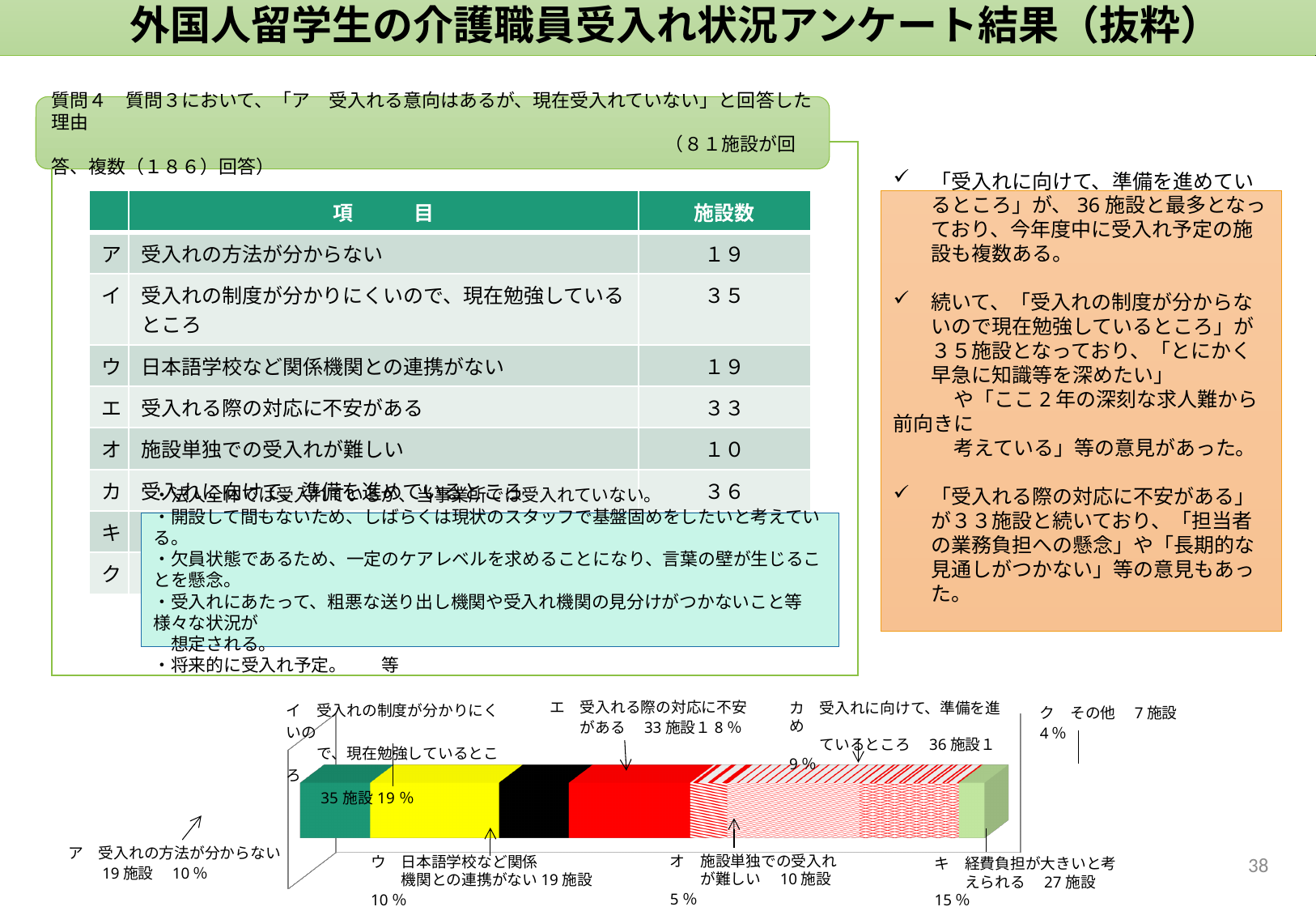
In the bar chart, what percentage is shown for 「ク その他」? 4％ In the bar chart, which has more facilities: 「エ 受入れる際の対応に不安がある」 or 「キ 経費負担が大きいと考えられる」? エ 受入れる際の対応に不安がある Which category in the bar chart has the largest number of facilities? カ 受入れに向けて、準備を進めているところ What kind of chart is shown at the bottom of the slide? bar chart Which category in the bar chart has the smallest number of facilities? ク その他 What is the total number of facilities across all segments of the stacked bar? 186 What colour is the segment for 「イ 受入れの制度が分かりにくいので、現在勉強しているところ」 in the bar chart? yellow In the bar chart, what is the difference in facility count between 「イ」 (35施設) and 「ア」 (19施設)? 16 In the bar chart, how many facilities are shown for 「オ 施設単独での受入れが難しい」? 10施設 In the bar chart, how many facilities are shown for 「イ 受入れの制度が分かりにくいので、現在勉強しているところ」? 35施設 How many segments (categories) does the stacked bar at the bottom of the slide contain? 8 In the bar chart, what percentage is shown for 「キ 経費負担が大きいと考えられる」? 15％